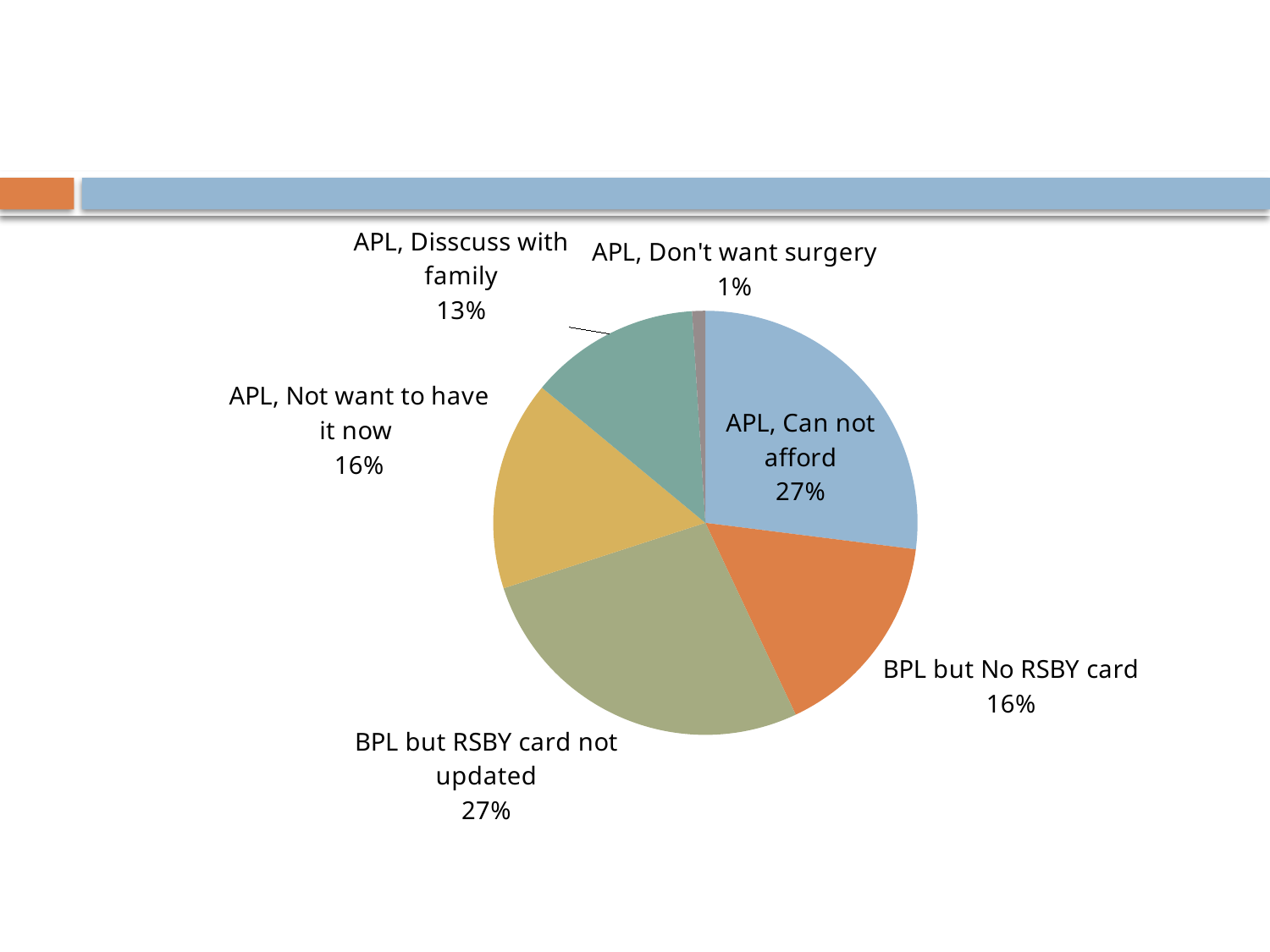
What share of the pie is labelled "APL, Disscuss with family"? 13% How many slices does the pie chart have? 6 What share of the pie is labelled "BPL but No RSBY card"? 16% What colour is the slice labelled "BPL but No RSBY card"? orange What is the difference in percentage points between "APL, Can not afford" and "APL, Disscuss with family"? 14% What share of the pie is labelled "APL, Can not afford"? 27% What is the combined share of the two slices labelled 27%, "APL, Can not afford" and "BPL but RSBY card not updated"? 54% Which is larger: the share for "APL, Not want to have it now" or the share for "APL, Disscuss with family"? APL, Not want to have it now Which slice of the pie chart is the smallest? APL, Don't want surgery What kind of chart is shown on the slide? pie chart